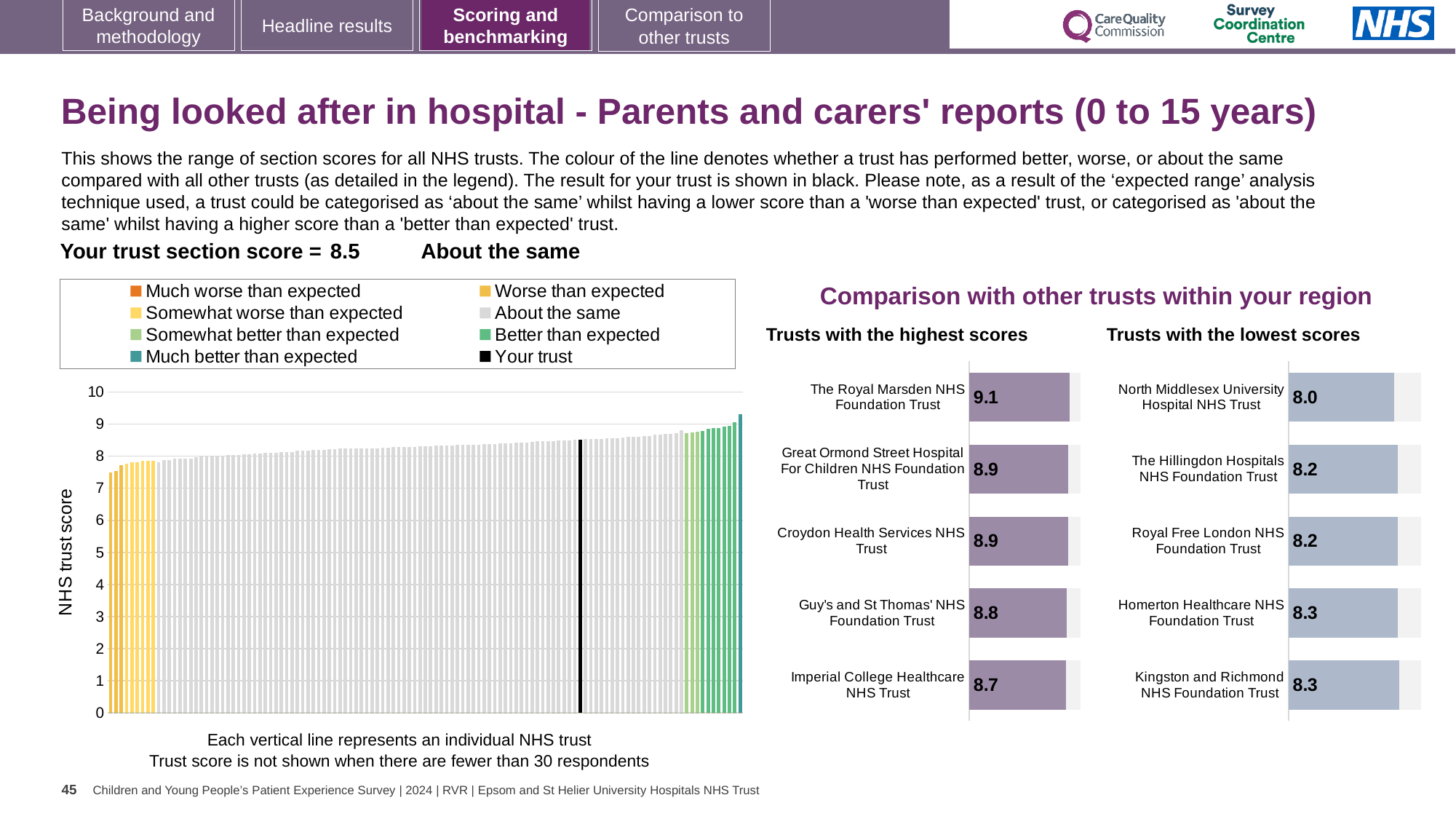
How many entries does the legend of the main chart on the left list? 8 In the 'Trusts with the highest scores' chart, what is the difference between the scores of The Royal Marsden NHS Foundation Trust and Imperial College Healthcare NHS Trust? 0.4 In the 'Trusts with the lowest scores' chart, what is the score for North Middlesex University Hospital NHS Trust? 8.0 In the 'Trusts with the highest scores' chart, what is the score for The Royal Marsden NHS Foundation Trust? 9.1 Which has the higher score: Guy's and St Thomas' NHS Foundation Trust in the highest-scores chart or The Hillingdon Hospitals NHS Foundation Trust in the lowest-scores chart? Guy's and St Thomas' NHS Foundation Trust In the main chart on the left showing all NHS trusts, do the values rise or fall from left to right? rise In the 'Trusts with the highest scores' chart, which trust has the highest score? The Royal Marsden NHS Foundation Trust In the 'Trusts with the lowest scores' chart, what is the difference between the scores of Homerton Healthcare NHS Foundation Trust and North Middlesex University Hospital NHS Trust? 0.3 In the 'Trusts with the highest scores' chart, what is the score for Imperial College Healthcare NHS Trust? 8.7 In the 'Trusts with the lowest scores' chart, which trust has the lowest score? North Middlesex University Hospital NHS Trust How many trusts are shown in the 'Trusts with the lowest scores' chart? 5 In the main chart on the left showing all NHS trusts, what is the section score for your trust? 8.5